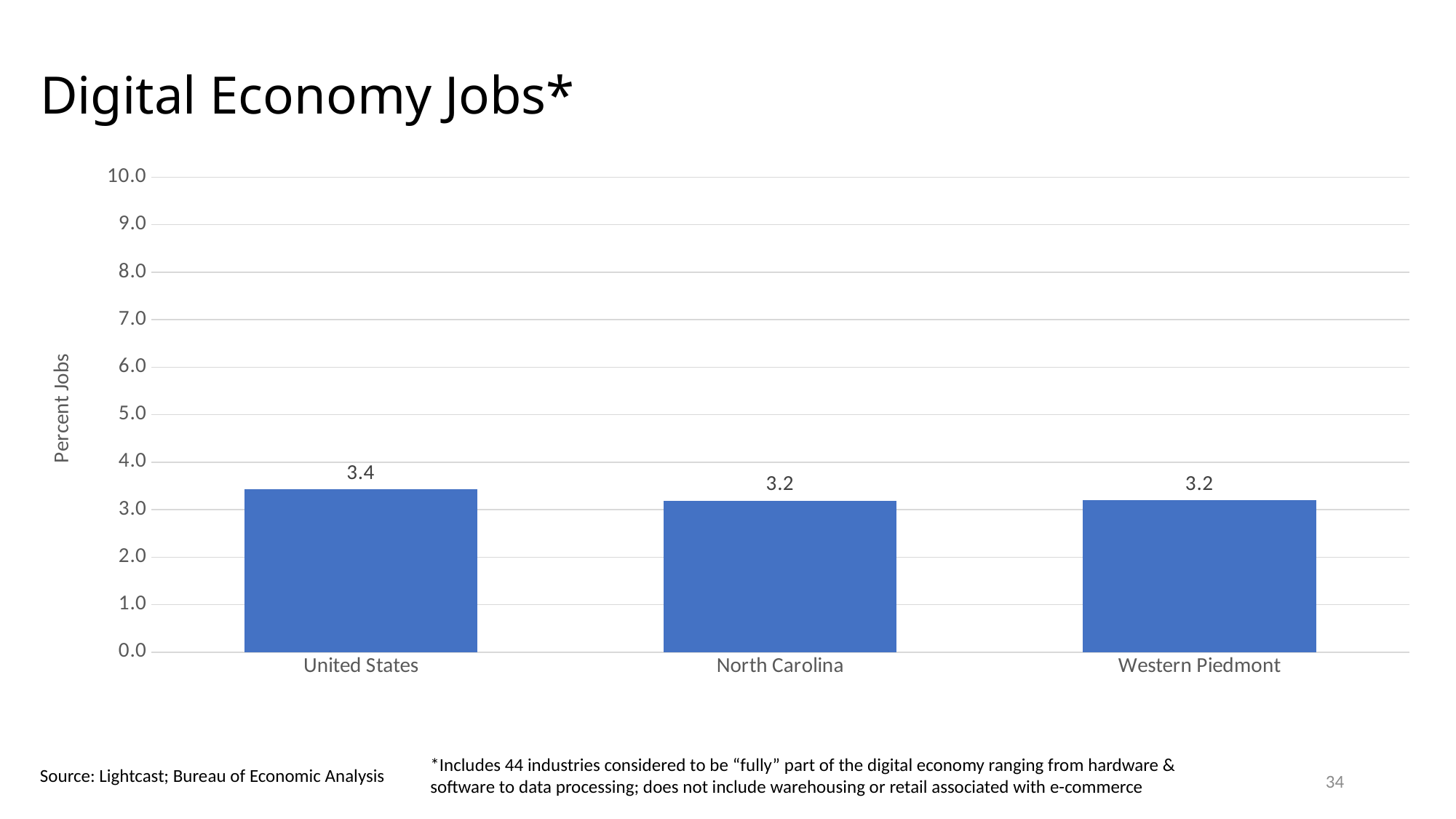
What is the value for United States? 3.4 What kind of chart is shown on the slide? bar chart How many categories are shown on the chart? 3 What is the value for Western Piedmont? 3.2 What is the difference between the values for United States and North Carolina? 0.2 Which category has the highest value? United States Is the value for North Carolina greater or less than 4.0? less What is the label on the vertical axis? Percent Jobs What is the value for North Carolina? 3.2 What is the title of the chart? Digital Economy Jobs* Which is larger, the value for United States or the value for Western Piedmont? United States Is the value for United States greater or less than 3.0? greater